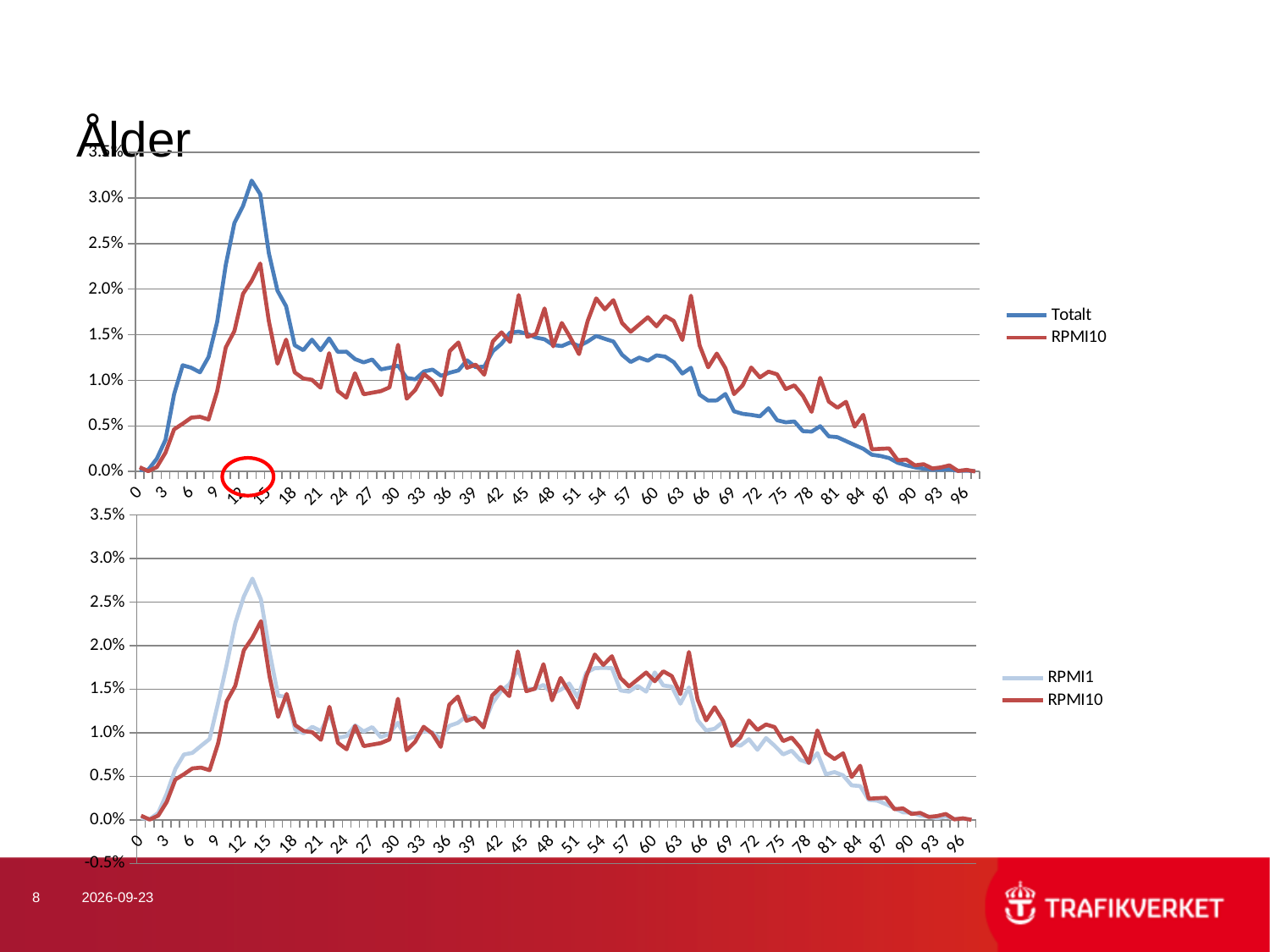
Which two series are listed in the legend of the bottom chart? RPMI1 and RPMI10 In the bottom chart, is the peak value of the RPMI1 series greater or less than 3.0%? less In the top chart, which series is higher at age 14, Totalt or RPMI10? Totalt In the top chart, is the peak value of the Totalt series greater or less than 3.0%? greater What type of chart is the top chart on the slide? Line chart In the top chart, which series is higher at age 63, Totalt or RPMI10? RPMI10 In the top chart, is the peak value of the RPMI10 series greater or less than 2.5%? less How many series does the legend of the top chart list? 2 What is the title of the slide above the charts? Ålder In the bottom chart, do the values of the RPMI10 series rise or fall between age 66 and age 96? fall